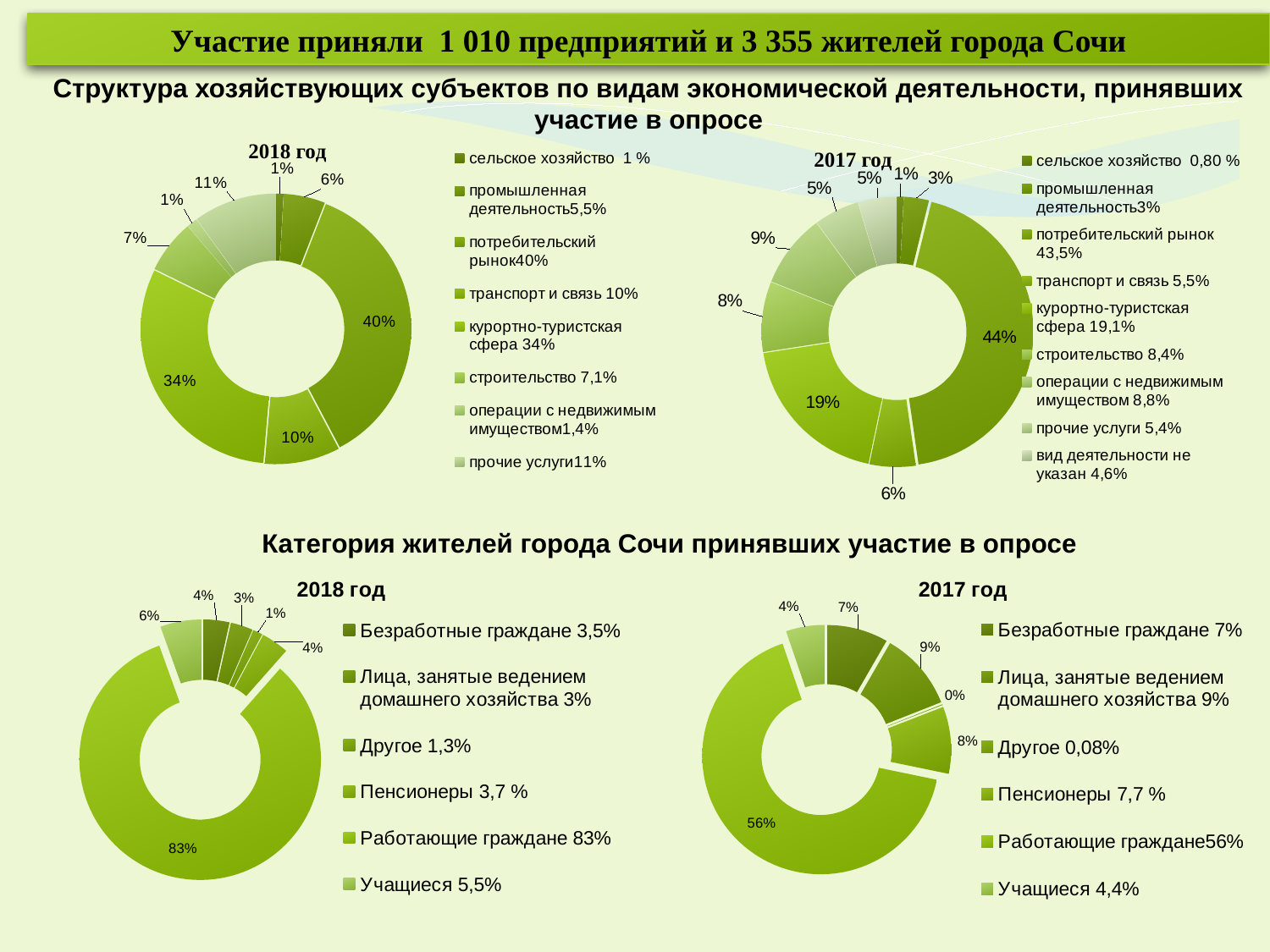
In the top-right '2017 год' chart (structure of economic entities), what is the difference between потребительский рынок (43,5%) and курортно-туристская сфера (19,1%)? 24,4% In the top-right '2017 год' chart (structure of economic entities), what share does строительство have according to the legend? 8,4% In the bottom-right '2017 год' chart (categories of residents), what share do Пенсионеры have according to the legend? 7,7 % In the top-right '2017 год' chart (structure of economic entities), which is larger: потребительский рынок or курортно-туристская сфера? потребительский рынок In the top-left '2018 год' chart (structure of economic entities), what share does курортно-туристская сфера have according to the legend? 34% In the bottom-right '2017 год' chart (categories of residents), which category has the smallest share? Другое (0,08%) What type of chart is used for the top-left '2018 год' chart showing the structure of economic entities? Doughnut (pie) chart In the bottom-left '2018 год' chart (categories of residents), what is the difference between Работающие граждане (83%) and Учащиеся (5,5%)? 77,5% How many categories does the legend of the bottom-left '2018 год' chart (categories of residents) list? 6 How many categories does the legend of the top-right '2017 год' chart (structure of economic entities) list? 9 In the bottom-left '2018 год' chart (categories of residents), which category has the largest share? Работающие граждане (83%) In the top-left '2018 год' chart (structure of economic entities), which category has the largest share? потребительский рынок (40%)